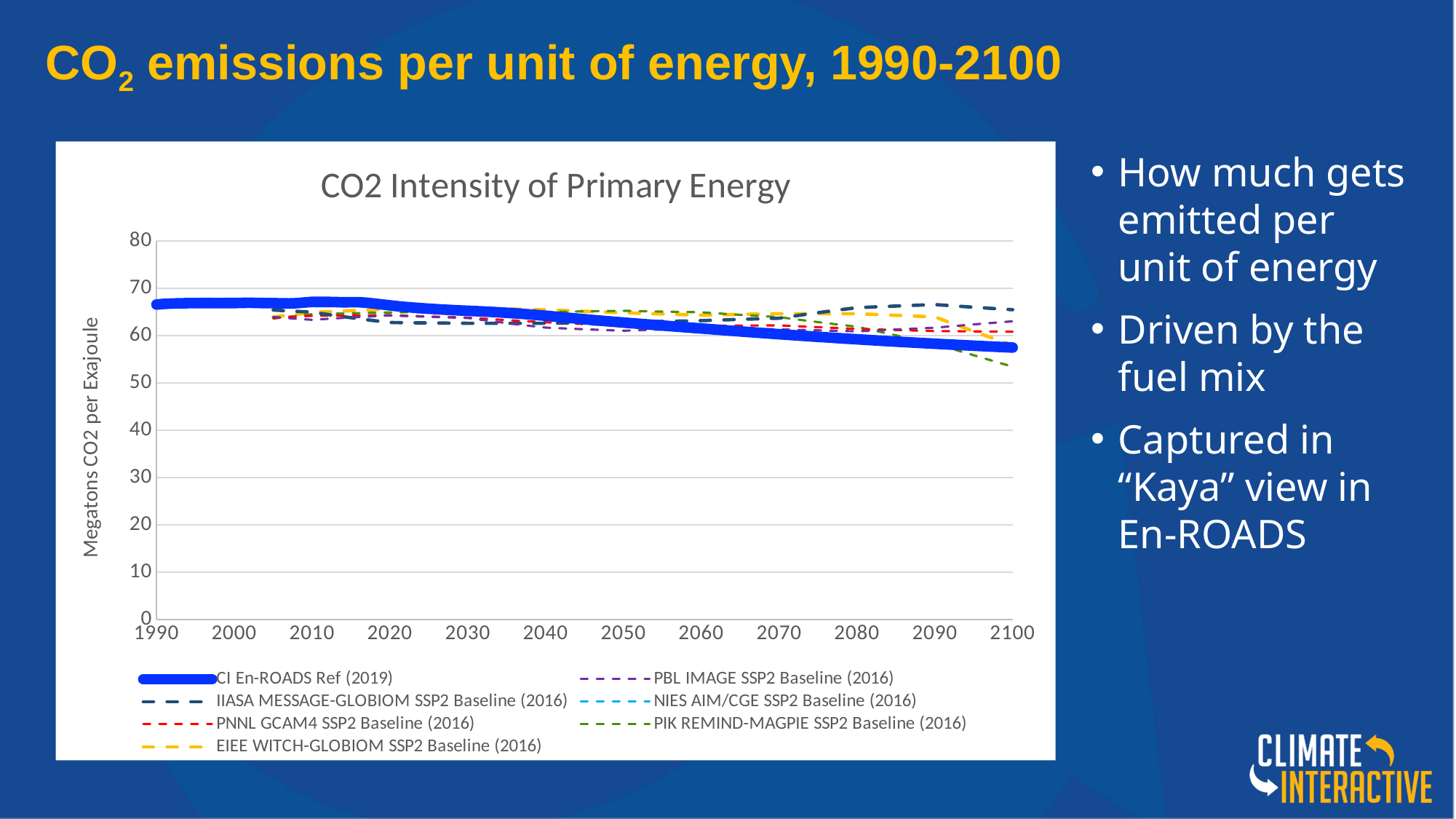
Is the value of CI En-ROADS Ref (2019) in 2100 greater or less than 60? less Which series has the lowest value in 2100? PIK REMIND-MAGPIE SSP2 Baseline (2016) How many series does the legend of the chart list? 7 What is the title of the chart? CO2 Intensity of Primary Energy Is the value of PIK REMIND-MAGPIE SSP2 Baseline (2016) in 2100 greater or less than 60? less In 2100, which is higher: IIASA MESSAGE-GLOBIOM SSP2 Baseline (2016) or CI En-ROADS Ref (2019)? IIASA MESSAGE-GLOBIOM SSP2 Baseline (2016) Is the value of CI En-ROADS Ref (2019) in 1990 greater or less than 60? greater Does the CI En-ROADS Ref (2019) line rise or fall from 1990 to 2100? fall What kind of chart is shown on the slide? line chart How many year labels are shown on the horizontal axis of the chart? 12 What is the label on the vertical axis of the chart? Megatons CO2 per Exajoule